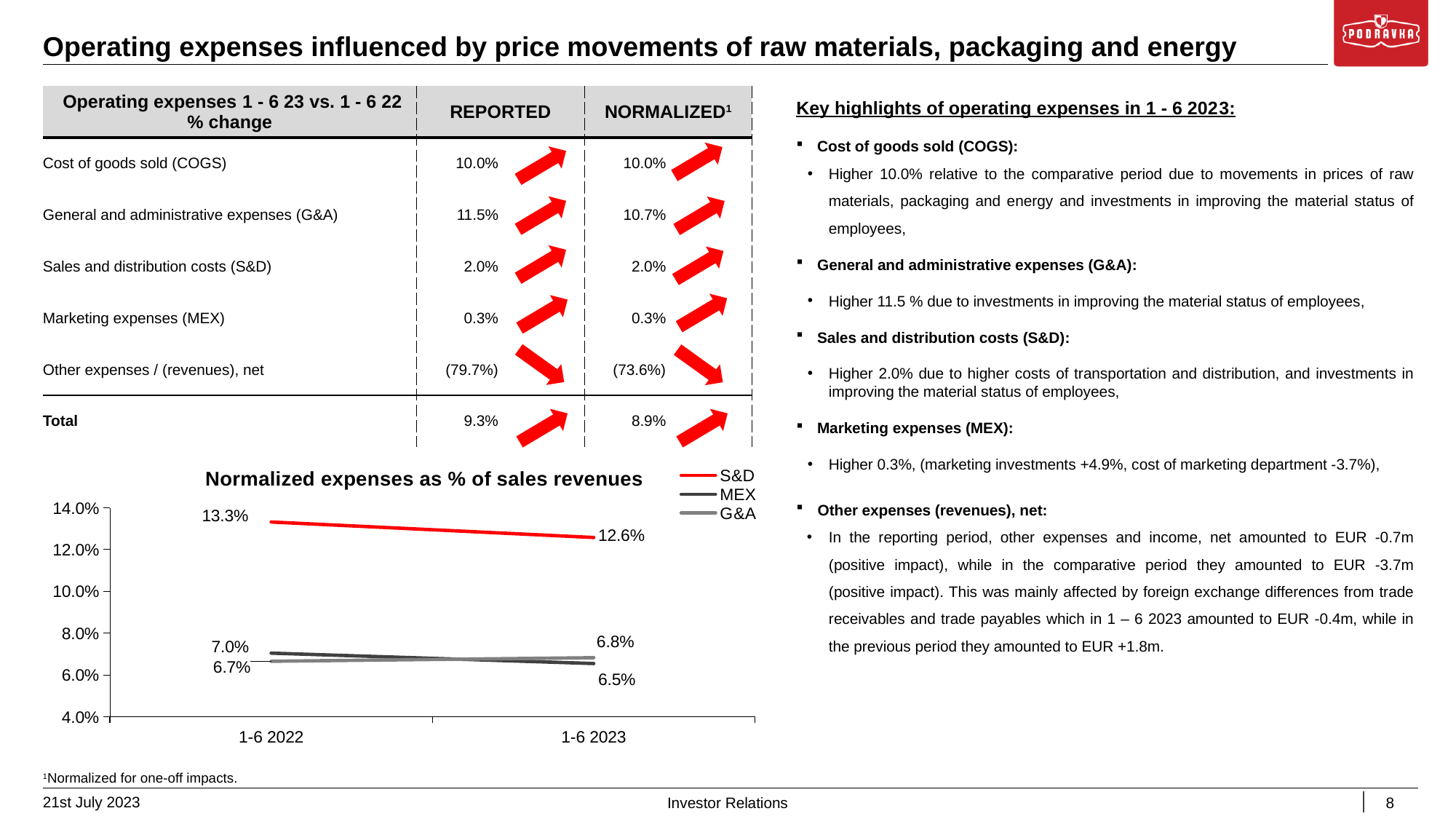
In the "Normalized expenses as % of sales revenues" chart, does the S&D line rise or fall from 1-6 2022 to 1-6 2023? Fall In the "Normalized expenses as % of sales revenues" chart, which series has the highest value in 1-6 2022? S&D In the "Normalized expenses as % of sales revenues" chart, is the value for S&D in 1-6 2023 greater or less than 12.0%? greater How many periods are shown on the x axis of the "Normalized expenses as % of sales revenues" chart? 2 How many series does the legend of the "Normalized expenses as % of sales revenues" chart list? 3 What kind of chart is "Normalized expenses as % of sales revenues"? Line chart In the "Normalized expenses as % of sales revenues" chart, what is the value for MEX in 1-6 2022? 7.0% In the "Normalized expenses as % of sales revenues" chart, what is the value for S&D in 1-6 2022? 13.3% In the "Normalized expenses as % of sales revenues" chart, by how many percentage points did S&D change from 1-6 2022 to 1-6 2023? 0.7 percentage points lower In the "Normalized expenses as % of sales revenues" chart, what is the value for S&D in 1-6 2023? 12.6% In the "Normalized expenses as % of sales revenues" chart, which is larger in 1-6 2022: S&D or MEX? S&D What is the title of the line chart on the slide? Normalized expenses as % of sales revenues